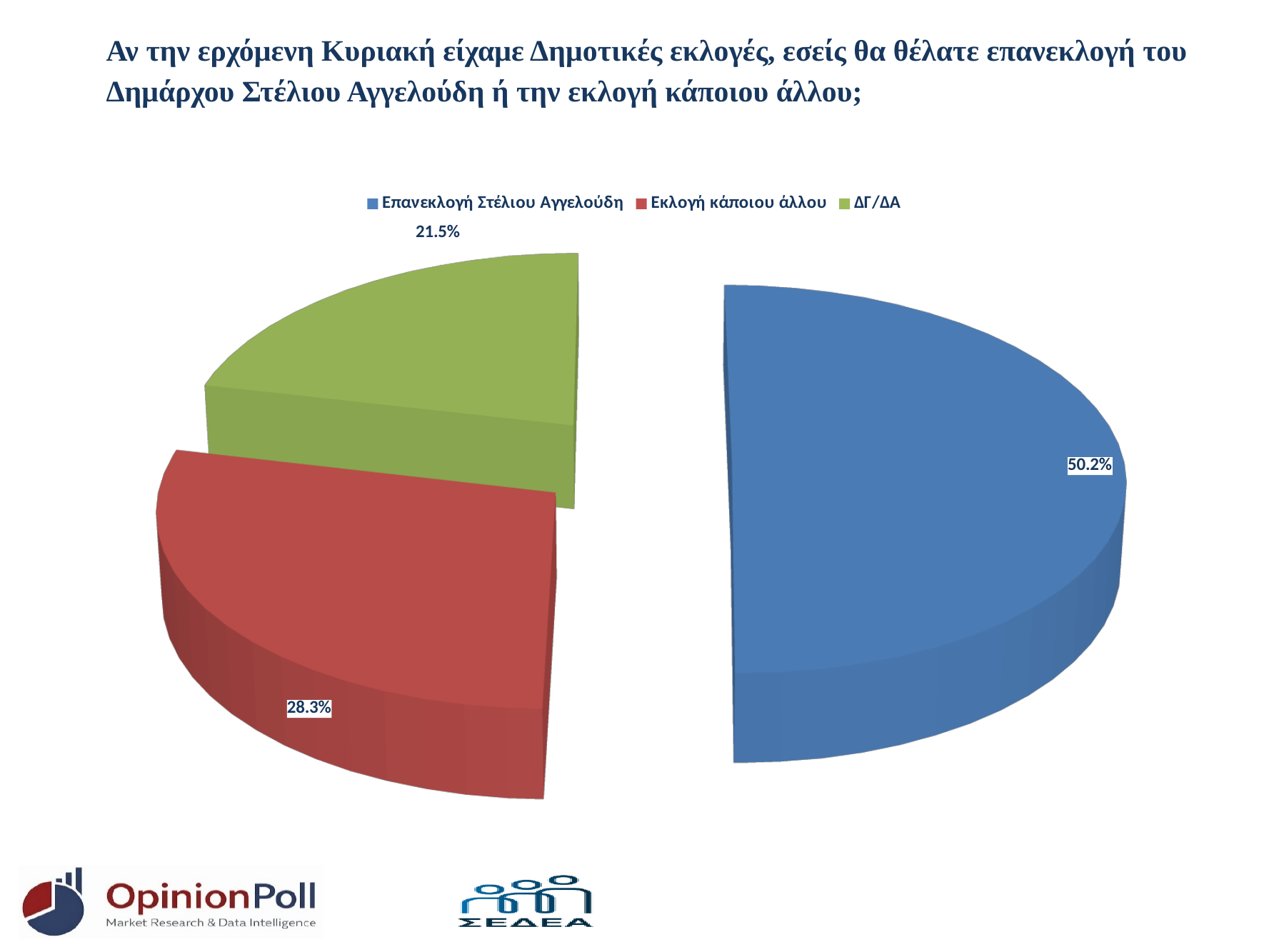
What colour is the slice for ΔΓ/ΔΑ? Green How many slices does the pie chart have? 3 What percentage of respondents chose Εκλογή κάποιου άλλου? 28.3% What colour is the slice for Εκλογή κάποιου άλλου? Red What is the difference in percentage points between Επανεκλογή Στέλιου Αγγελούδη and Εκλογή κάποιου άλλου? 21.9 What percentage of respondents chose Επανεκλογή Στέλιου Αγγελούδη? 50.2% What is the difference in percentage points between Εκλογή κάποιου άλλου and ΔΓ/ΔΑ? 6.8 What kind of chart is shown on the slide? Pie chart What percentage of respondents answered ΔΓ/ΔΑ? 21.5% Which is larger: the share for Εκλογή κάποιου άλλου or the share for ΔΓ/ΔΑ? Εκλογή κάποιου άλλου Which response has the smallest share of the pie? ΔΓ/ΔΑ Which response has the largest share of the pie? Επανεκλογή Στέλιου Αγγελούδη